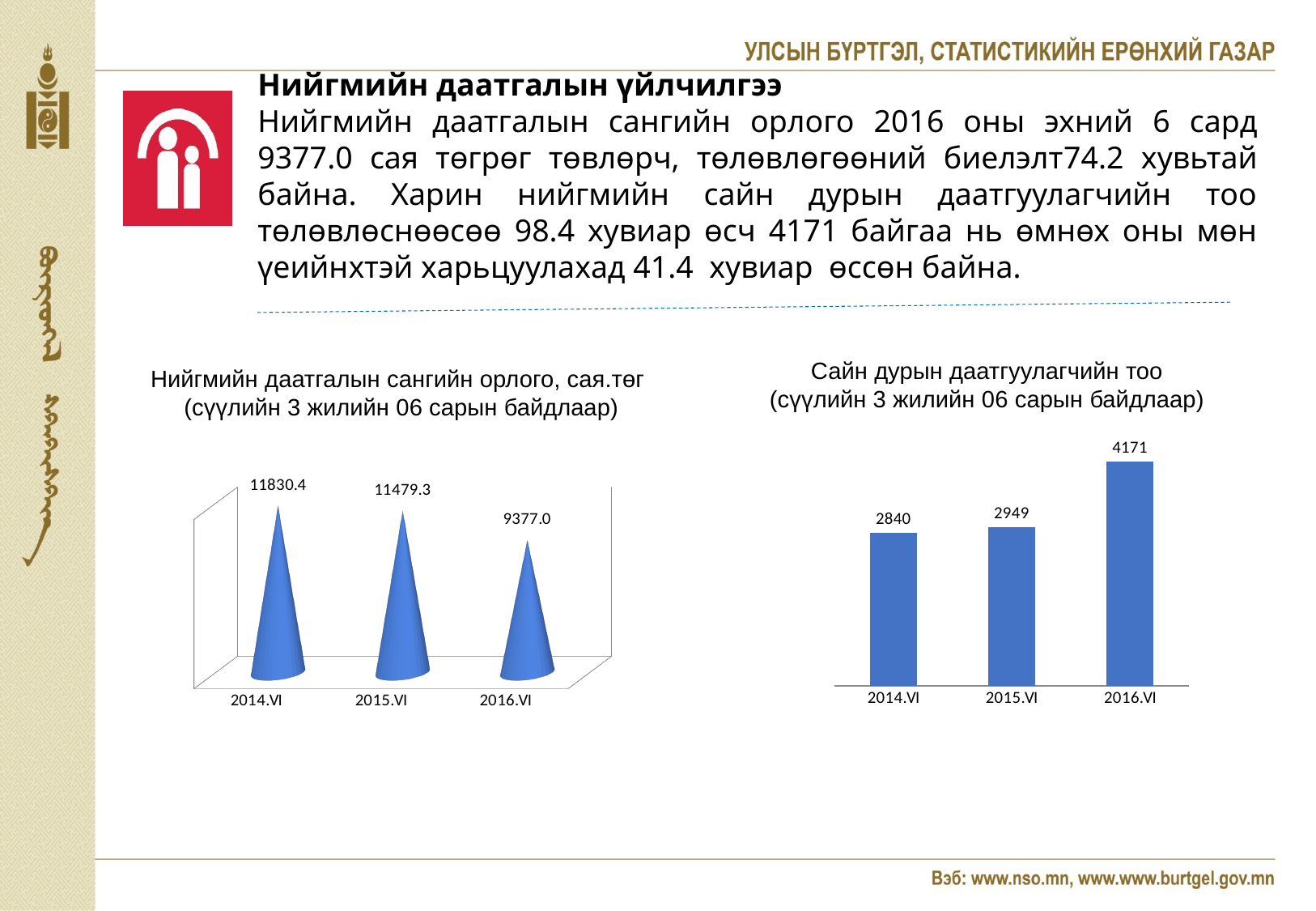
In the left chart (Нийгмийн даатгалын сангийн орлого), what is the value for 2016.VI? 9377.0 In the left chart (Нийгмийн даатгалын сангийн орлого), which period has the highest value? 2014.VI In the right chart (Сайн дурын даатгуулагчийн тоо), what is the difference between the 2016.VI and 2014.VI values? 1331 In the left chart (Нийгмийн даатгалын сангийн орлого), what is the difference between the 2014.VI and 2016.VI values? 2453.4 In the right chart (Сайн дурын даатгуулагчийн тоо), what is the value for 2015.VI? 2949 In the right chart (Сайн дурын даатгуулагчийн тоо), which period has the lowest value? 2014.VI What kind of chart is the right chart (Сайн дурын даатгуулагчийн тоо)? bar chart In the right chart (Сайн дурын даатгуулагчийн тоо), how many periods are shown on the x axis? 3 In the left chart (Нийгмийн даатгалын сангийн орлого), what is the value for 2014.VI? 11830.4 In the left chart (Нийгмийн даатгалын сангийн орлого), do the values rise or fall from 2014.VI to 2016.VI? fall In the right chart (Сайн дурын даатгуулагчийн тоо), do the values rise or fall from 2014.VI to 2016.VI? rise In the right chart (Сайн дурын даатгуулагчийн тоо), which is larger, the value for 2016.VI or 2015.VI? 2016.VI